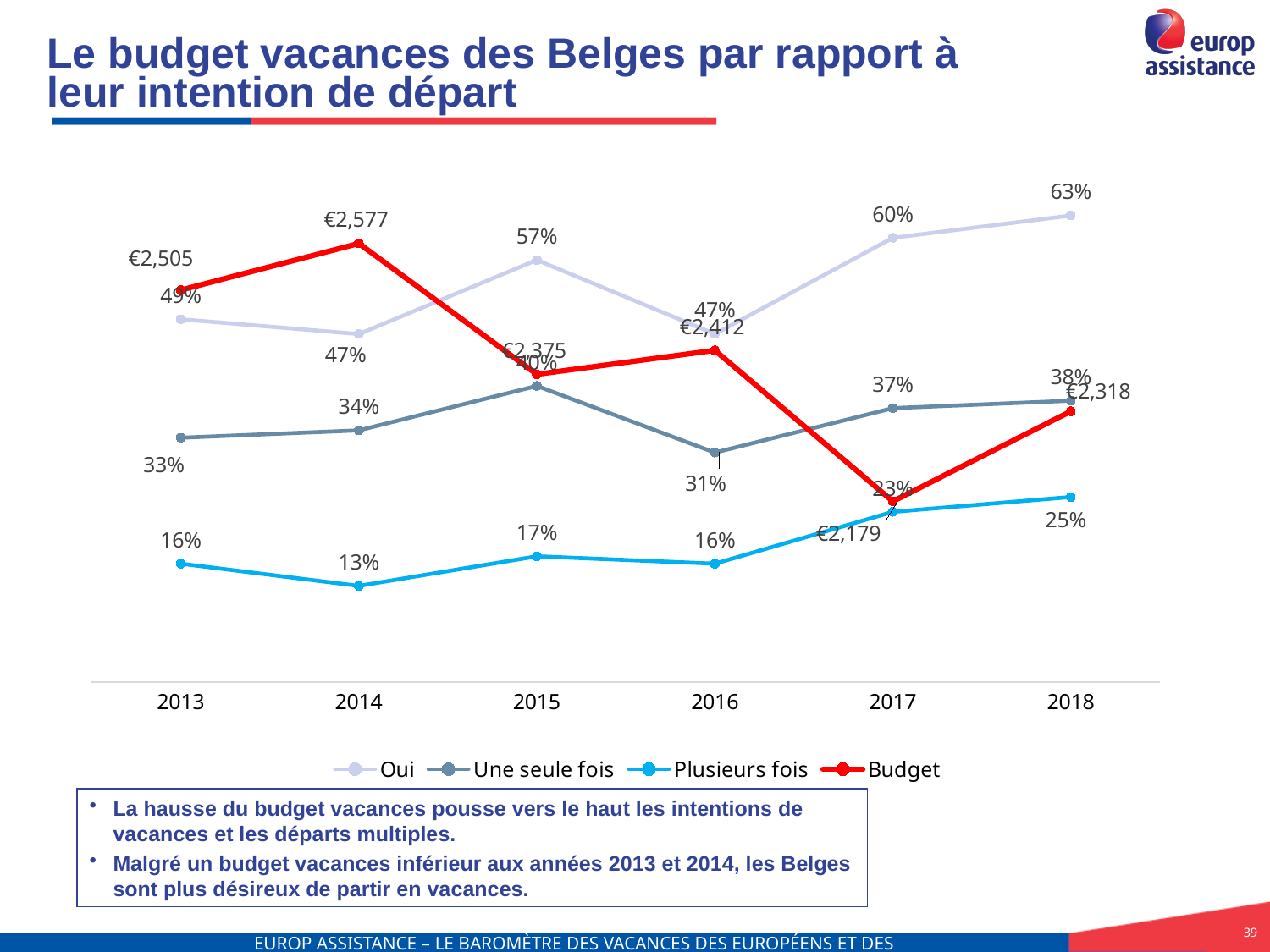
What is the value for 'Une seule fois' in 2016? 31% Does the 'Oui' series rise or fall from 2016 to 2018? rise What is the value for 'Oui' in 2018? 63% In which year is the 'Budget' series lowest? 2017 What kind of chart is shown on the slide? line chart What is the difference between the 'Oui' values for 2018 and 2017? 3% What is the 'Budget' value in 2014? €2,577 What is the value for 'Plusieurs fois' in 2014? 13% For 'Une seule fois', which year has the larger value, 2015 or 2016? 2015 How many series does the legend list? 4 How many years are shown on the x axis? 6 In which year is the 'Budget' series highest? 2014